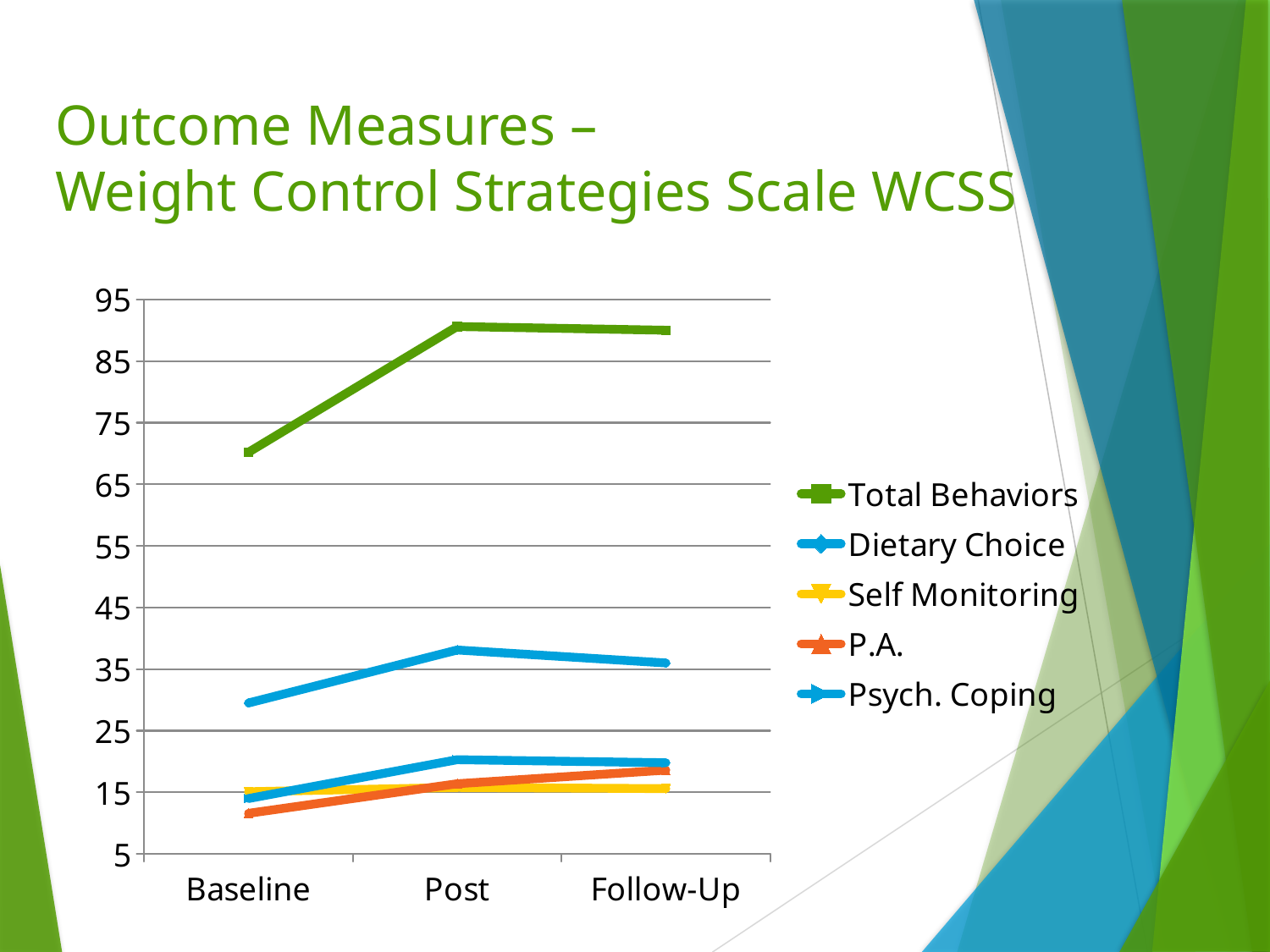
Is the value for Total Behaviors at Baseline greater or less than 65? greater How many series does the legend list? 5 Is the value for P.A. at Baseline greater or less than 15? less What are the three categories on the x axis? Baseline, Post, Follow-Up Is the value for Self Monitoring at Follow-Up greater or less than 25? less Which series has the highest value at Post? Total Behaviors Does the Total Behaviors line rise or fall from Baseline to Post? rises What kind of chart is shown on the slide? line chart For Total Behaviors, which is larger: the value at Baseline or the value at Post? Post How many time points are shown on the x axis? 3 Which series has the lowest value at Baseline? P.A.